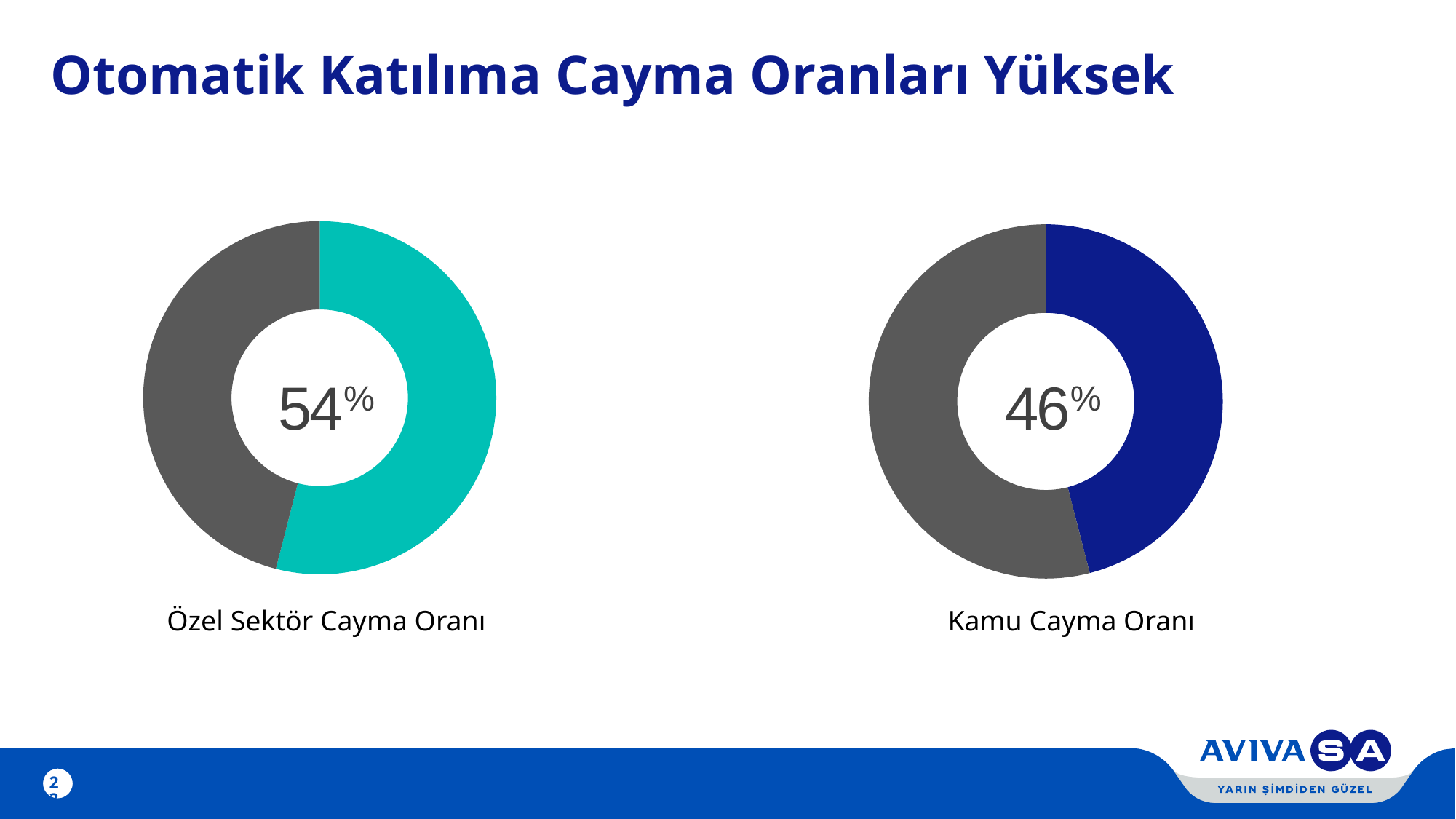
What colour is the highlighted slice in the Kamu Cayma Oranı donut chart? Dark blue What kind of chart is used to show the Özel Sektör Cayma Oranı? Donut (pie) chart Which is higher, the Özel Sektör Cayma Oranı or the Kamu Cayma Oranı? Özel Sektör Cayma Oranı What is the title of the slide containing the two donut charts? Otomatik Katılıma Cayma Oranları Yüksek Which of the two charts shows the higher cayma oranı? Özel Sektör Cayma Oranı Which of the two charts shows the lower cayma oranı? Kamu Cayma Oranı How many donut charts are shown on the slide? 2 By how many percentage points does the Özel Sektör Cayma Oranı exceed the Kamu Cayma Oranı? 8 What is the value shown in the centre of the Özel Sektör Cayma Oranı donut chart? 54% Is the value in the Özel Sektör Cayma Oranı chart greater or less than 50%? greater Is the value in the Kamu Cayma Oranı chart greater or less than 50%? less What is the value shown in the centre of the Kamu Cayma Oranı donut chart? 46%